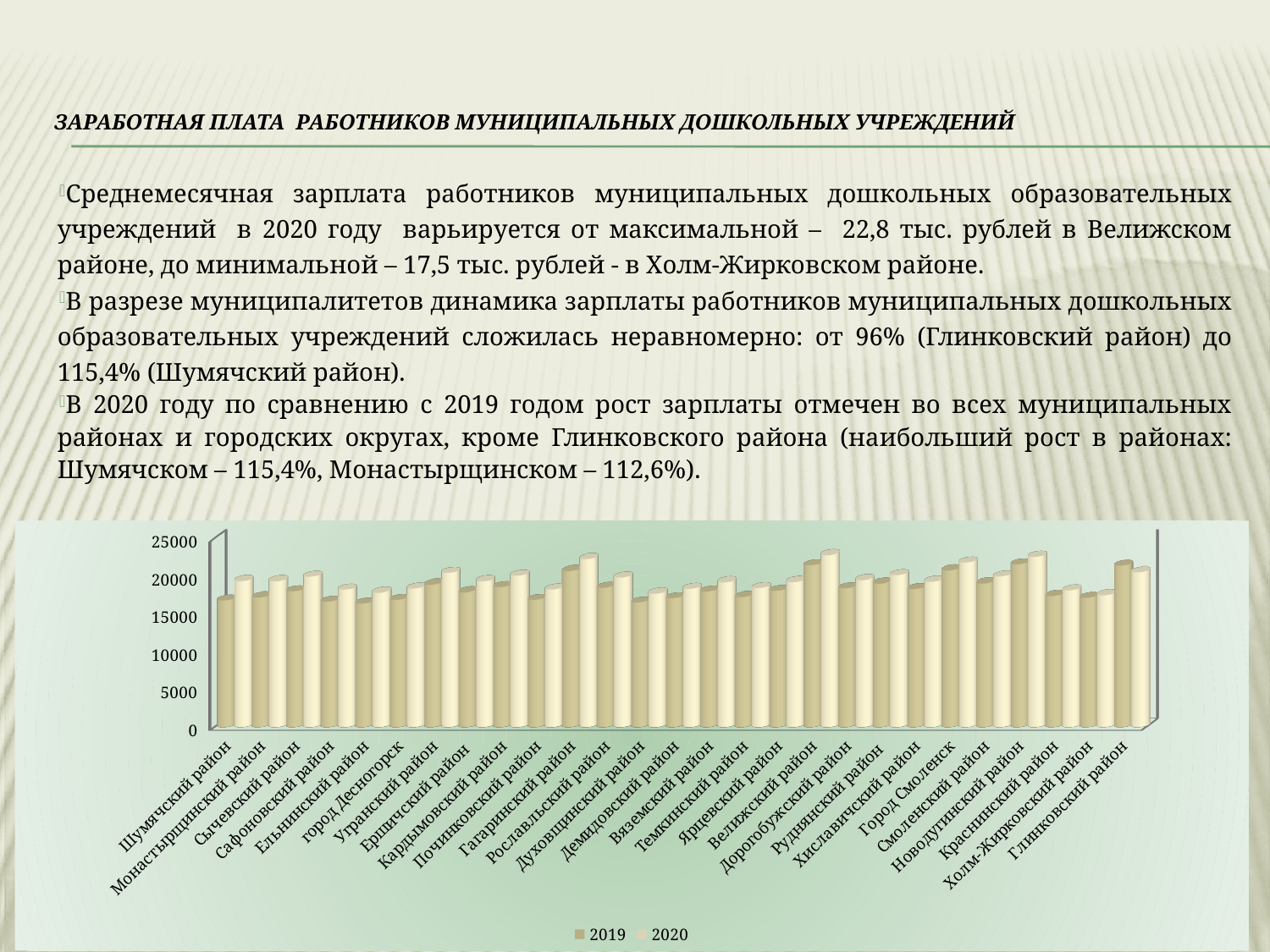
Is the 2020 value for Холм-Жирковский район greater or less than 20000? less Which municipality has the lowest 2020 value in the chart? Холм-Жирковский район How many municipalities (categories) are shown on the x axis of the chart? 27 How many series does the chart legend list? 2 For Глинковский район, which is larger: the 2019 value or the 2020 value? 2019 Is the 2020 value for Велижский район greater or less than 20000? greater For Шумячский район, which is larger: the 2019 value or the 2020 value? 2020 What kind of chart is shown on the slide? bar chart Is the 2019 value for Шумячский район greater or less than 20000? less Which years are listed in the chart legend? 2019 and 2020 Which municipality has the highest 2020 value in the chart? Велижский район